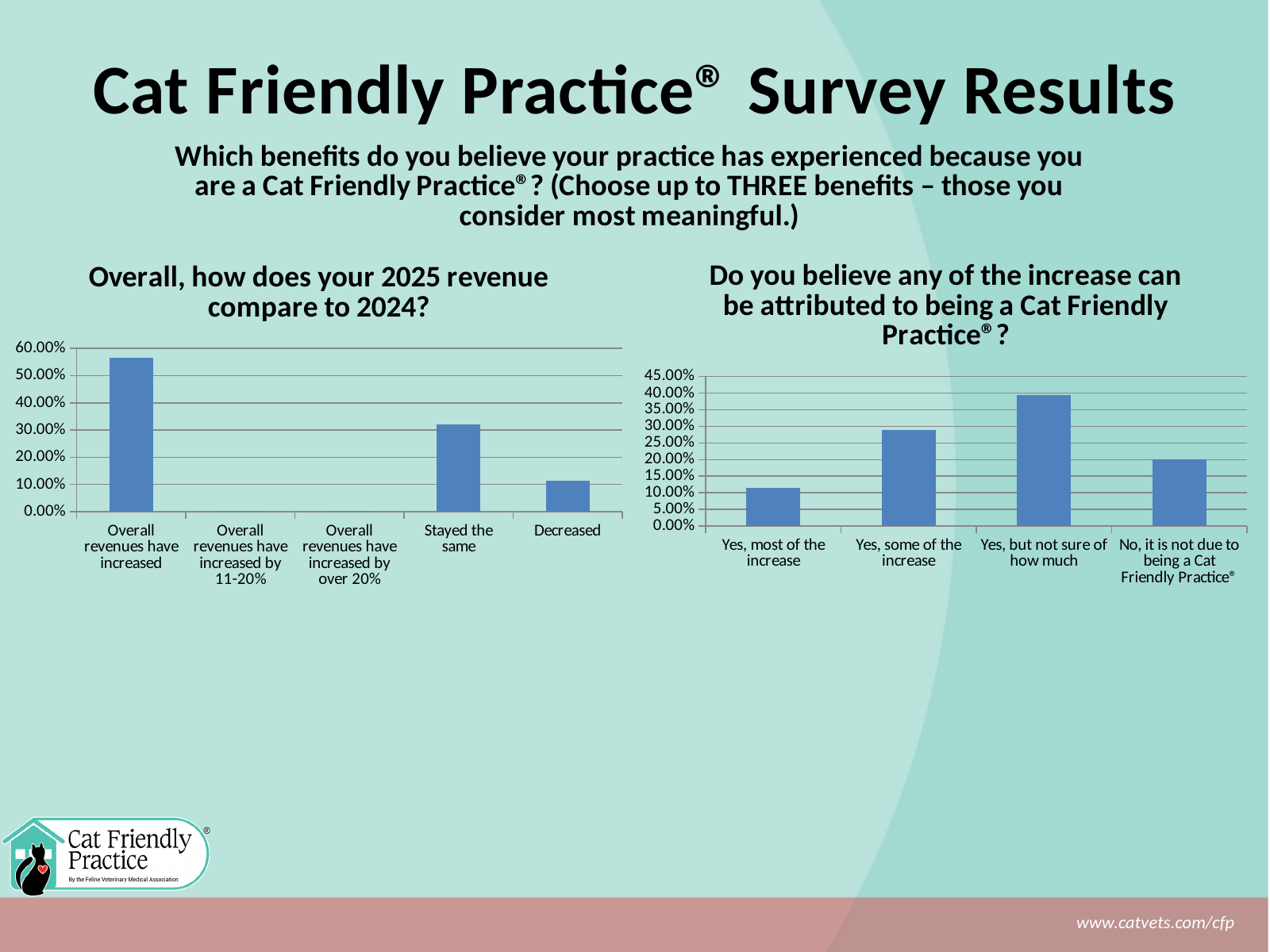
In the left chart (2025 revenue compared to 2024), how many categories are shown on the x axis? 5 In the left chart (2025 revenue compared to 2024), which is larger: "Stayed the same" or "Decreased"? Stayed the same In the right chart (increase attributed to being a Cat Friendly Practice), how many categories are shown? 4 What is the highest value shown on the y axis of the right chart (increase attributed to being a Cat Friendly Practice)? 45.00% In the left chart (2025 revenue compared to 2024), which category has the highest value? Overall revenues have increased In the right chart (increase attributed to being a Cat Friendly Practice), which category has the lowest value? Yes, most of the increase In the right chart (increase attributed to being a Cat Friendly Practice), which category has the highest value? Yes, but not sure of how much In the left chart (2025 revenue compared to 2024), is the value for "Decreased" greater or less than 20.00%? less In the right chart (increase attributed to being a Cat Friendly Practice), is the value for "Yes, some of the increase" greater or less than 25.00%? greater In the left chart (2025 revenue compared to 2024), is the value for "Overall revenues have increased" greater or less than 50.00%? greater What kind of chart is the left chart titled "Overall, how does your 2025 revenue compare to 2024?"? Bar chart In the right chart (increase attributed to being a Cat Friendly Practice), which is larger: "Yes, some of the increase" or "No, it is not due to being a Cat Friendly Practice"? Yes, some of the increase